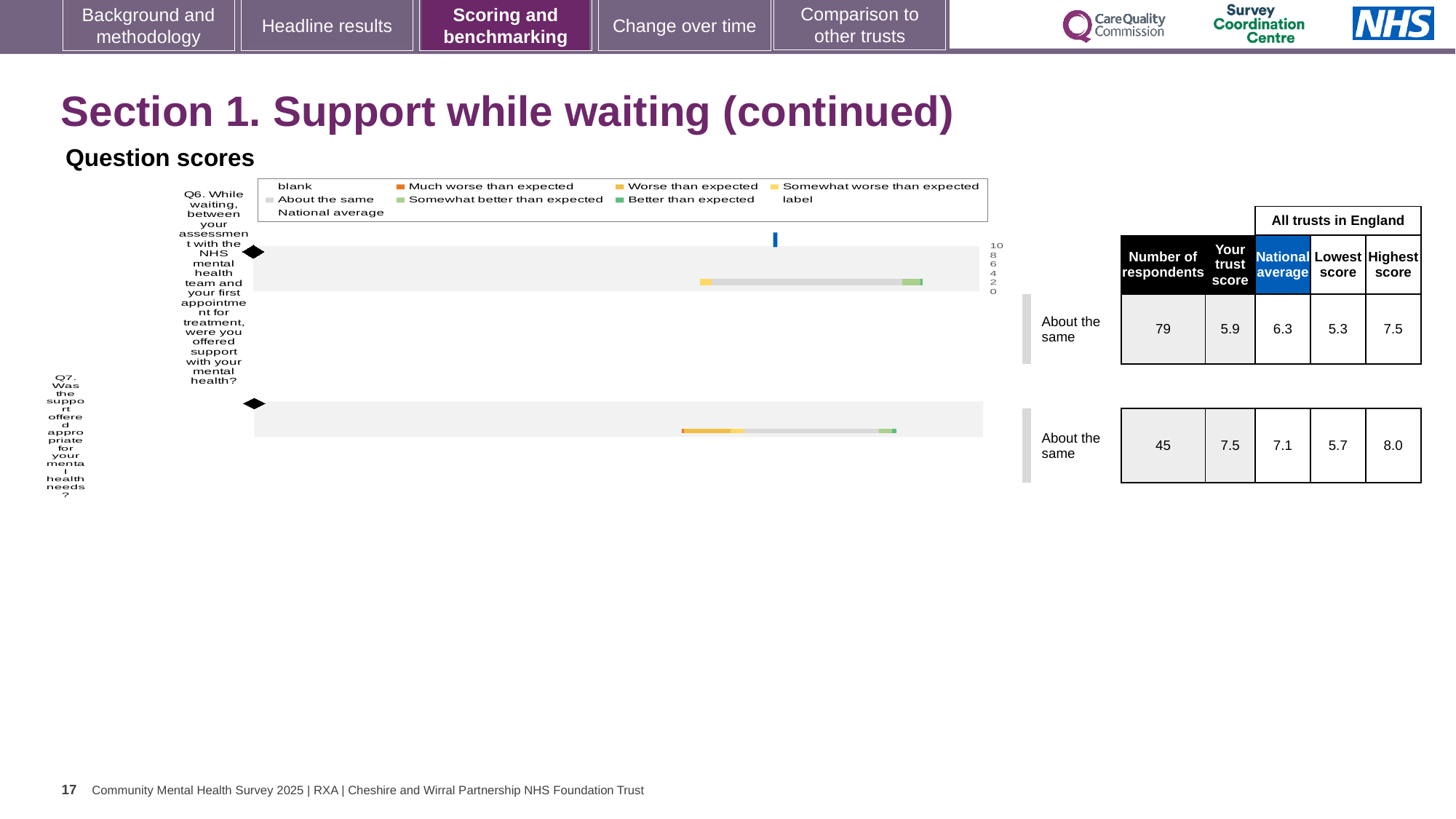
What is the difference between the highest and lowest scores for Q7? 2.3 What is the highest value shown on the score axis of the chart? 10 Which question has the higher trust score, Q6 or Q7? Q7 What is the highest score among all trusts in England for Q7? 8.0 What is the national average for Q6? 6.3 What is the lowest score among all trusts in England for Q6? 5.3 What is the number of respondents for Q6 in the question scores table? 79 What is the trust score for Q7 (was the support offered appropriate)? 7.5 How many questions are plotted in the question scores chart? 2 For Q6, which is larger: the trust score or the national average? national average What is the trust score for Q6 (support with mental health while waiting)? 5.9 What kind of chart is used to show the question scores on this slide? bar chart